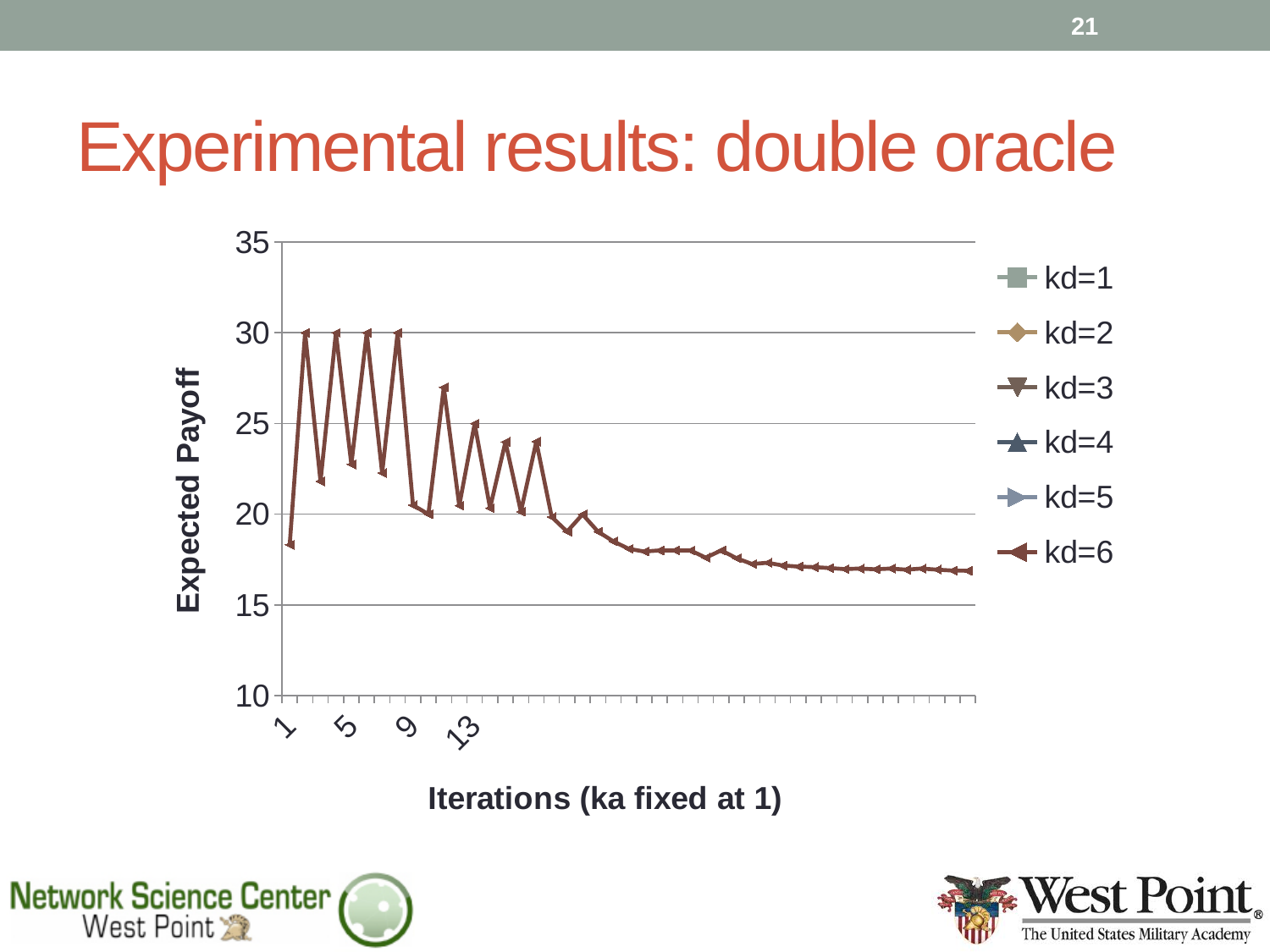
Is the expected payoff at iteration 1 greater or less than 20? less What is the title of the horizontal axis? Iterations (ka fixed at 1) What is the highest value shown on the vertical axis? 35 What kind of chart is shown on the slide? line chart Is the expected payoff at the last iteration shown greater or less than 15? greater How many series does the legend list? 6 Is the expected payoff at iteration 2 greater or less than 25? greater What is the title of the vertical axis? Expected Payoff Over the later iterations, does the expected payoff rise or fall as the iterations increase? fall